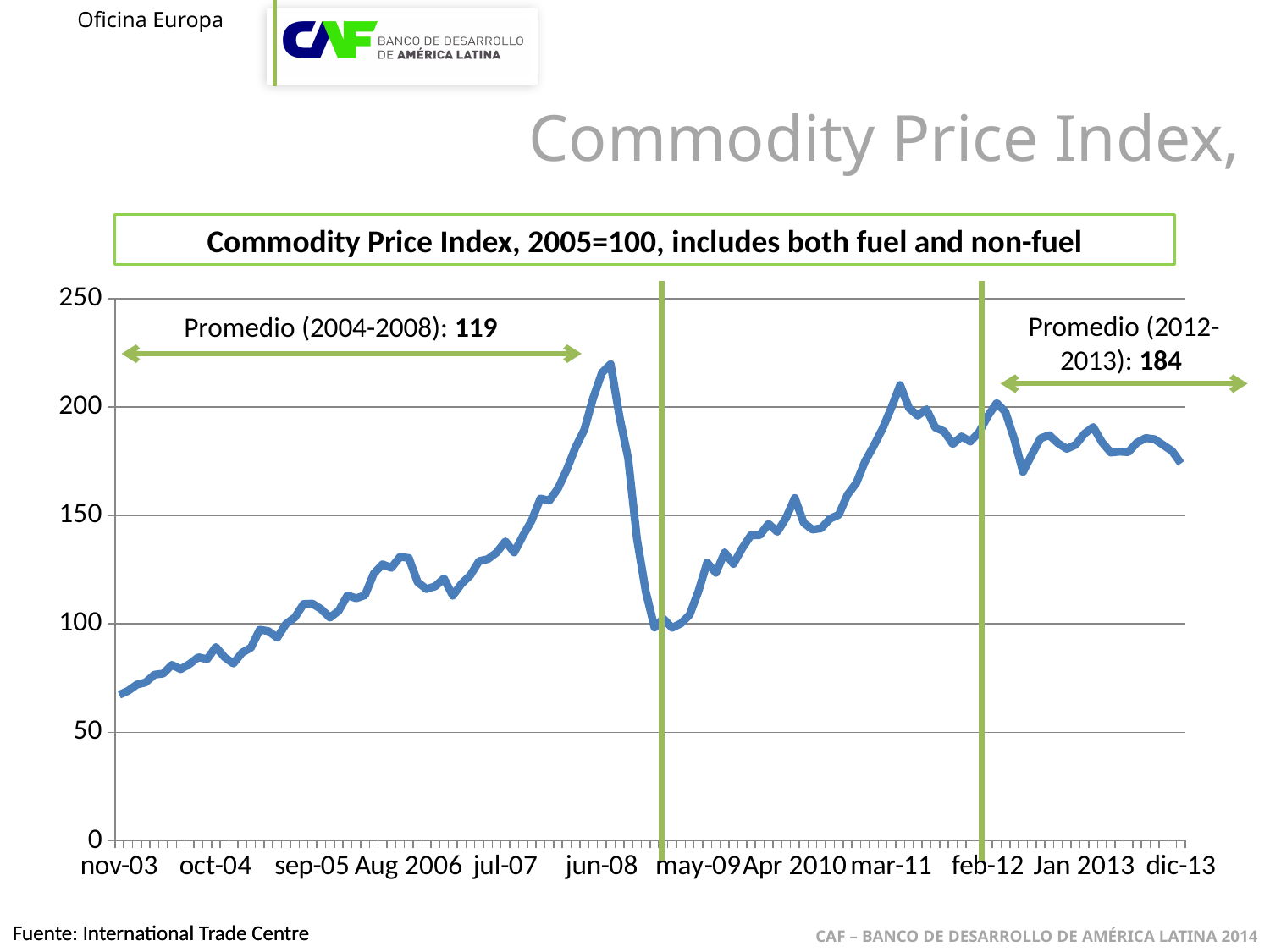
Is the value of the index at nov-03 greater or less than 100? less What is the title of the chart? Commodity Price Index, 2005=100, includes both fuel and non-fuel What kind of chart is shown on the slide? line chart Is the value of the index at jun-08 greater or less than 200? greater Does the index rise or fall between nov-03 and jun-08? rise Which is larger, the index value at jun-08 or at may-09? jun-08 What average (Promedio) value is annotated for the period 2012-2013? 184 Is the value of the index at dic-13 greater or less than 150? greater What average (Promedio) value is annotated for the period 2004-2008? 119 Which annotated average is larger, the 2004-2008 average or the 2012-2013 average? 2012-2013 What is the difference between the annotated 2012-2013 average and the 2004-2008 average? 65